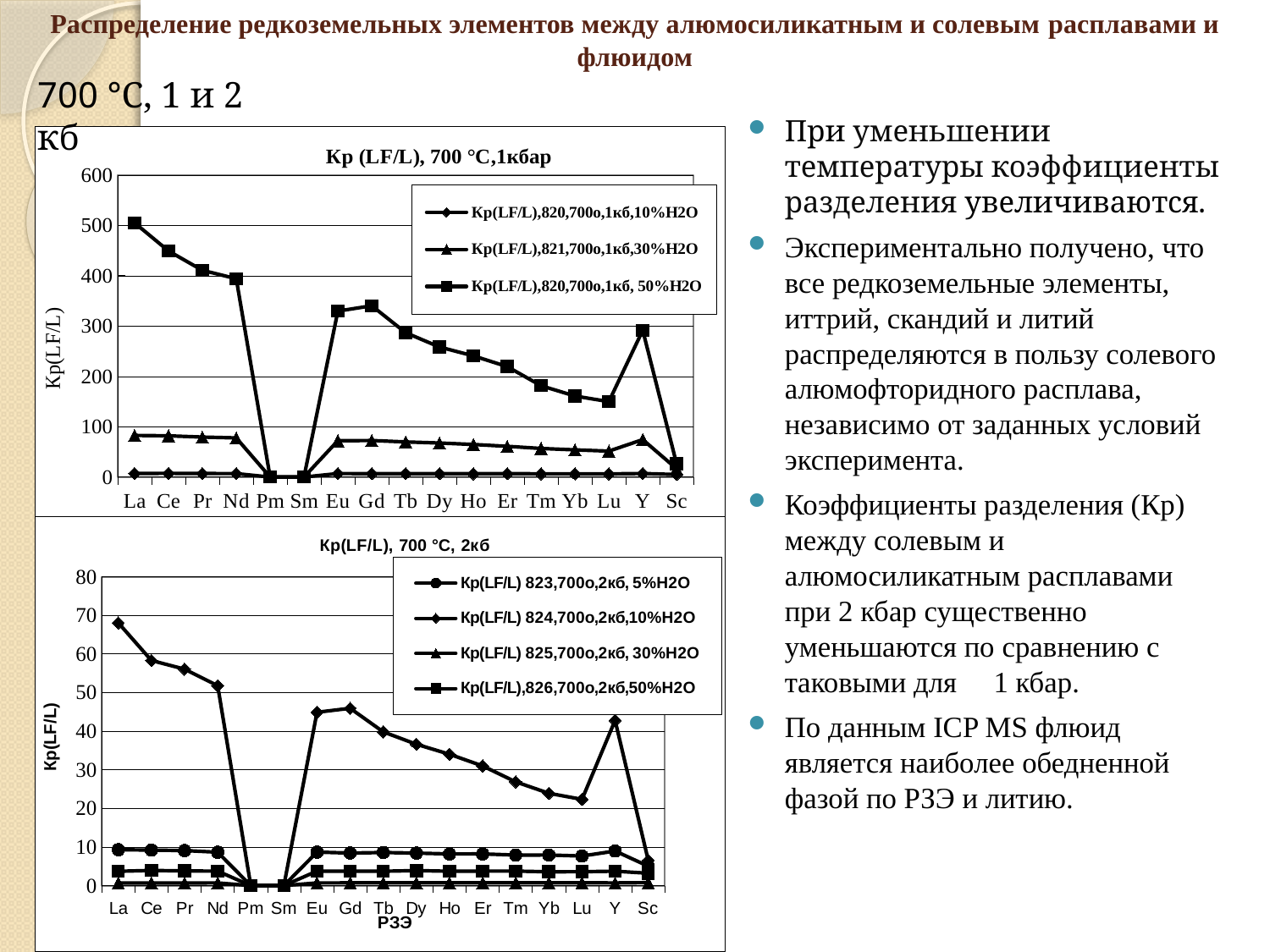
In the top chart (700 °C, 1 кбар), is the value for Lu in the 50%H2O series greater or less than 200? less How many series does the legend of the top chart (700 °C, 1 кбар) list? 3 In the top chart (700 °C, 1 кбар), which element has the highest value for the 50%H2O series? La What type of chart is the top chart titled "Кр (LF/L), 700 °C,1кбар"? line chart In the top chart (700 °C, 1 кбар), is the value for La in the 50%H2O series greater or less than 400? greater How many series does the legend of the bottom chart (700 °C, 2кб) list? 4 In the top chart (700 °C, 1 кбар), do the values of the 50%H2O series rise or fall from La to Nd? fall In the bottom chart (700 °C, 2кб), which element has the highest value for the 10%H2O series? La In the top chart (700 °C, 1 кбар), which is larger for the 50%H2O series: the value for La or the value for Y? La How many elements are shown along the x axis of the bottom chart (700 °C, 2кб)? 17 In the bottom chart (700 °C, 2кб), is the value for Lu in the 10%H2O series greater or less than 30? less